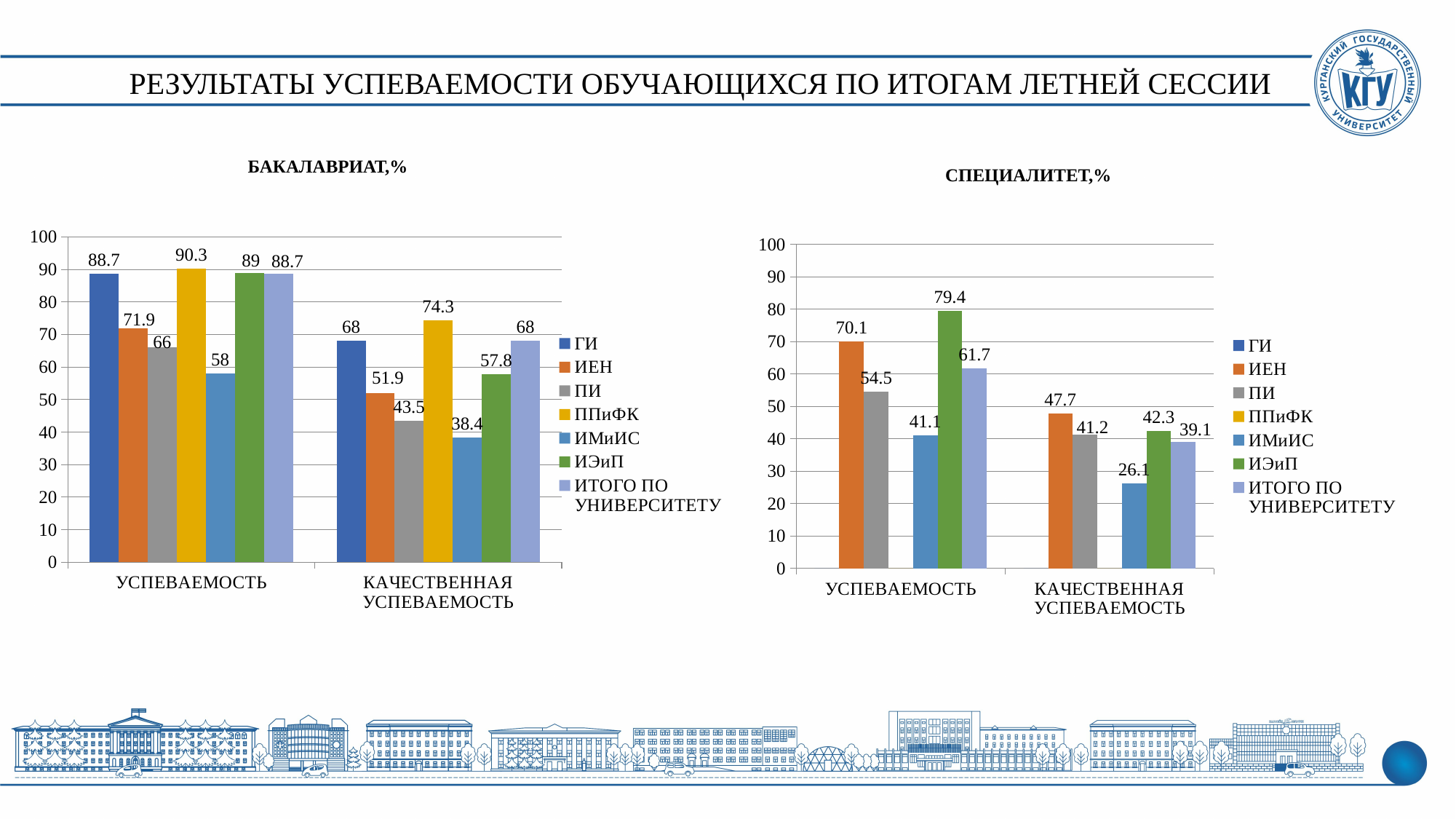
On the БАКАЛАВРИАТ,% chart, what colour are the ППиФК bars? Yellow On the БАКАЛАВРИАТ,% chart, what is the value for ППиФК in the УСПЕВАЕМОСТЬ category? 90.3 On the СПЕЦИАЛИТЕТ,% chart, what is the value for ИТОГО ПО УНИВЕРСИТЕТУ in the КАЧЕСТВЕННАЯ УСПЕВАЕМОСТЬ category? 39.1 On the БАКАЛАВРИАТ,% chart, which series has the lowest value in the УСПЕВАЕМОСТЬ category? ИМиИС On the СПЕЦИАЛИТЕТ,% chart, what is the difference between the ИЕН and ПИ values in the УСПЕВАЕМОСТЬ category? 15.6 On the БАКАЛАВРИАТ,% chart, what is the difference between the ППиФК and ИМиИС values in the КАЧЕСТВЕННАЯ УСПЕВАЕМОСТЬ category? 35.9 What kind of chart is the СПЕЦИАЛИТЕТ,% chart? Bar chart On the СПЕЦИАЛИТЕТ,% chart, which is larger in the КАЧЕСТВЕННАЯ УСПЕВАЕМОСТЬ category: ИЕН or ИЭиП? ИЕН On the БАКАЛАВРИАТ,% chart, what is the value for ИМиИС in the КАЧЕСТВЕННАЯ УСПЕВАЕМОСТЬ category? 38.4 On the СПЕЦИАЛИТЕТ,% chart, which series has the highest value in the УСПЕВАЕМОСТЬ category? ИЭиП On the СПЕЦИАЛИТЕТ,% chart, what is the value for ИЭиП in the УСПЕВАЕМОСТЬ category? 79.4 How many series does the legend of the БАКАЛАВРИАТ,% chart list? 7